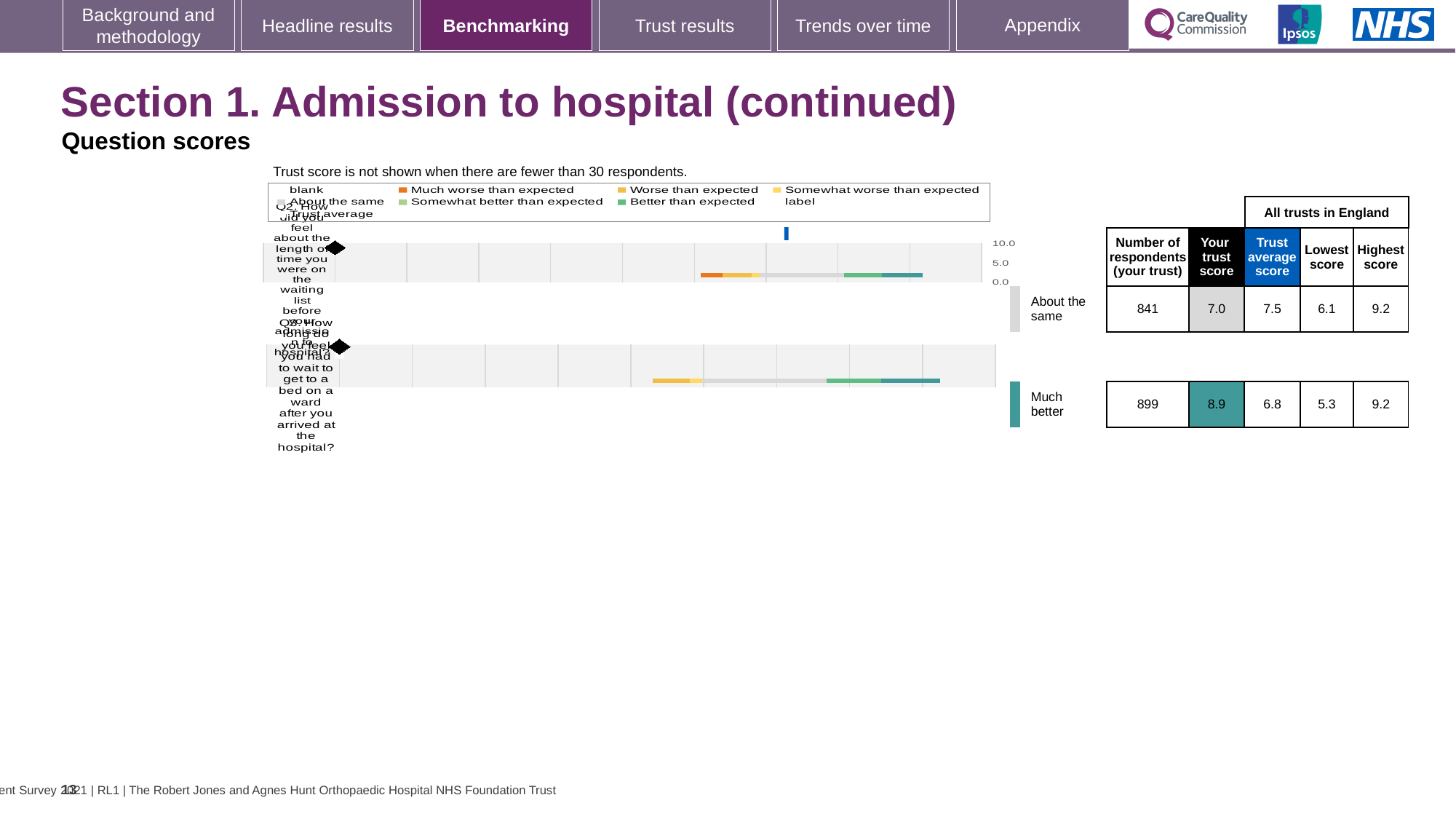
Which benchmark category is shown for Q2? About the same What is the trust score for Q3 (how long did you feel you had to wait to get to a bed on a ward)? 8.9 What is the highest score across all trusts in England for Q2? 9.2 How many questions are plotted in the benchmarking charts on this slide? 2 Which benchmark category is shown for Q3? Much better What kind of chart is used to show the question scores for Q2 and Q3? Bar chart What is the difference between the trust scores for Q3 and Q2? 1.9 What is the trust score for Q2 (how did you feel about the length of time on the waiting list)? 7.0 What is the maximum value shown on the score axis of the charts? 10.0 What is the lowest score across all trusts in England for Q3? 5.3 Is the trust score for Q3 greater or less than 5.0? greater Which question has the higher trust score, Q2 or Q3? Q3